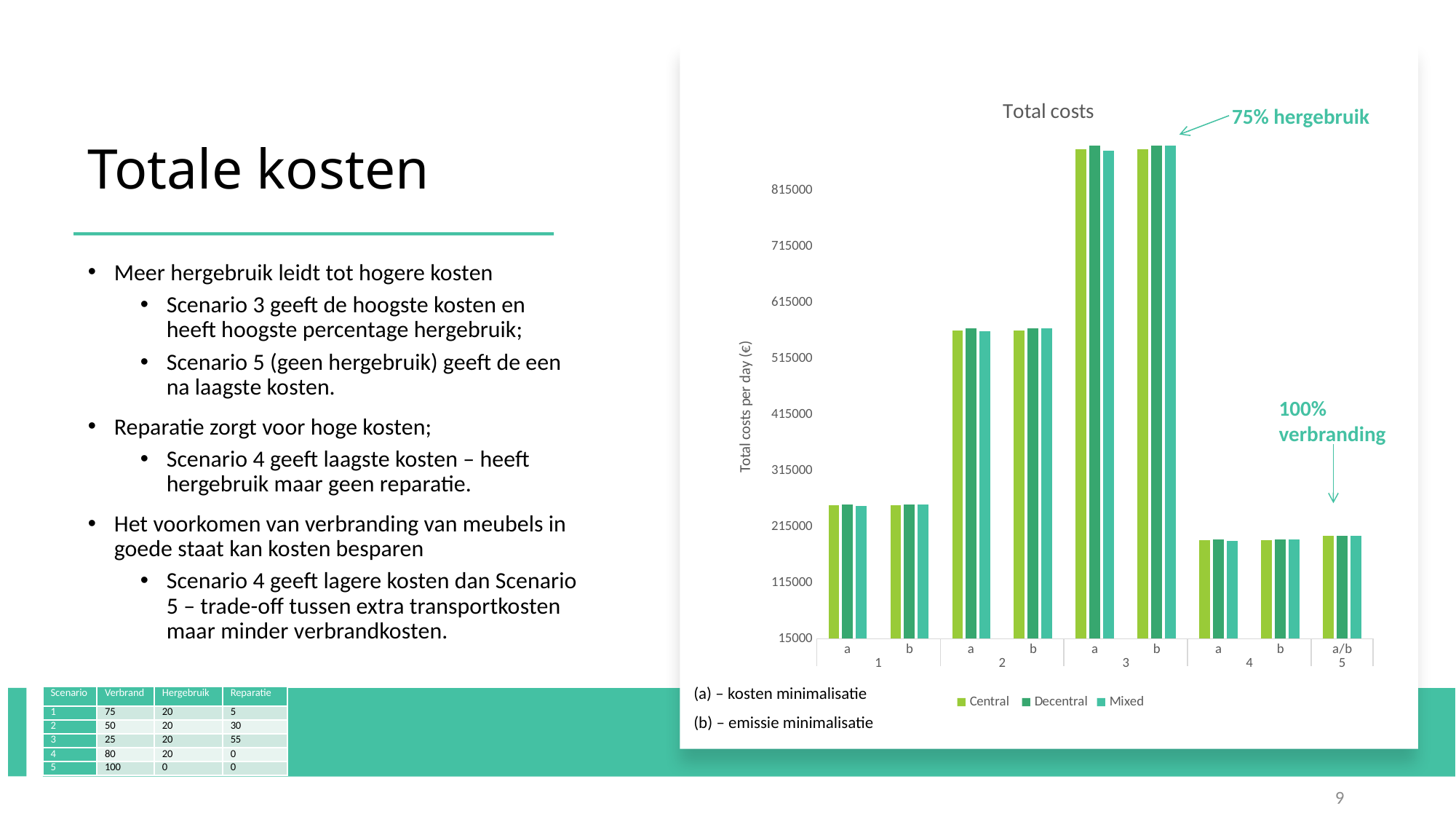
Is the Central value for scenario 4a greater or less than 215000? less Is the Central value for scenario 3a greater or less than 815000? greater How many category groups (a/b cases) are shown along the x axis of the Total costs chart? 9 Which has the larger Mixed value: scenario 3b or scenario 4b? scenario 3b Which has the larger Central value: scenario 2a or scenario 1a? scenario 2a What kind of chart is shown on the slide? bar chart Is the Central value for scenario 2a greater or less than 615000? less Which scenario has the highest bars in the Total costs chart? Scenario 3 How many series does the legend of the Total costs chart list? 3 What is the y-axis label of the Total costs chart? Total costs per day (€) What are the series names in the legend of the Total costs chart? Central, Decentral, Mixed